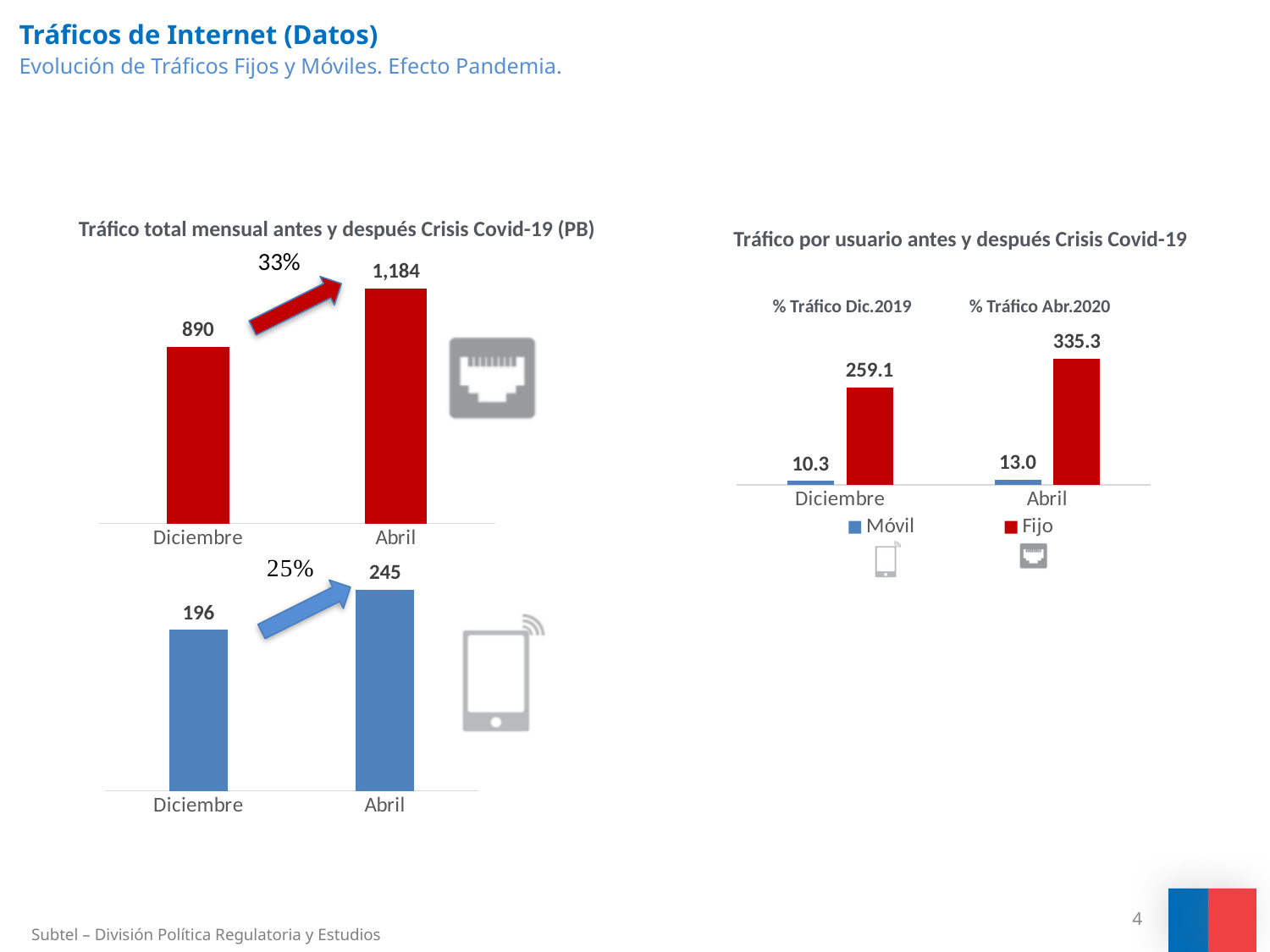
What percentage increase is shown by the arrow on the top-left red bar chart? 33% In the chart 'Tráfico por usuario antes y después Crisis Covid-19', what is the Móvil value for Diciembre? 10.3 In the chart 'Tráfico por usuario antes y después Crisis Covid-19', how many series does the legend list? 2 In the bottom-left blue bar chart, which month has the higher value? Abril In the top-left red bar chart, what is the value for Diciembre? 890 What type of chart is the top-left chart 'Tráfico total mensual antes y después Crisis Covid-19 (PB)'? Bar chart In the bottom-left blue bar chart, what is the value for Abril? 245 In the top-left chart 'Tráfico total mensual antes y después Crisis Covid-19 (PB)', what is the value for Abril? 1,184 In the chart 'Tráfico por usuario antes y después Crisis Covid-19', what is the difference between the Fijo values for Abril and Diciembre? 76.2 In the top-left red bar chart, what is the difference between the Abril and Diciembre values? 294 In the bottom-left blue bar chart, what is the difference between Abril and Diciembre? 49 In the chart 'Tráfico por usuario antes y después Crisis Covid-19', what is the Fijo value for Abril? 335.3